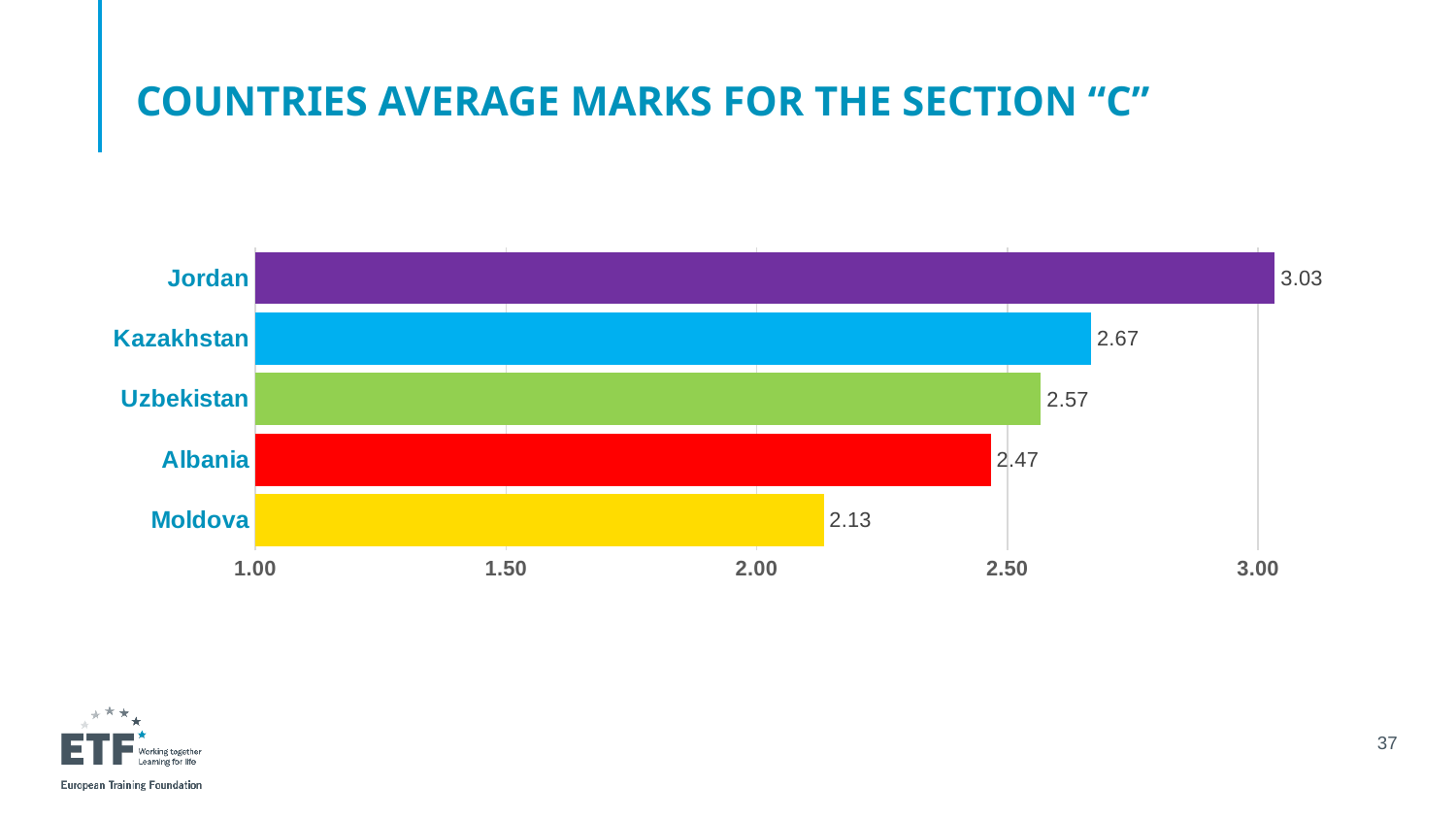
Which has a higher average mark, Kazakhstan or Uzbekistan? Kazakhstan Which country has the highest average mark? Jordan What is the difference between the average marks of Kazakhstan and Albania? 0.20 What is the average mark for Moldova? 2.13 What is the average mark for Uzbekistan? 2.57 What is the title of the chart? COUNTRIES AVERAGE MARKS FOR THE SECTION "C" How many countries are shown in the chart? 5 What is the average mark for Jordan? 3.03 What is the difference between the average marks of Jordan and Moldova? 0.90 What kind of chart is shown on the slide? Bar chart Is the value for Albania greater or less than 2.50? less Which country has the lowest average mark? Moldova